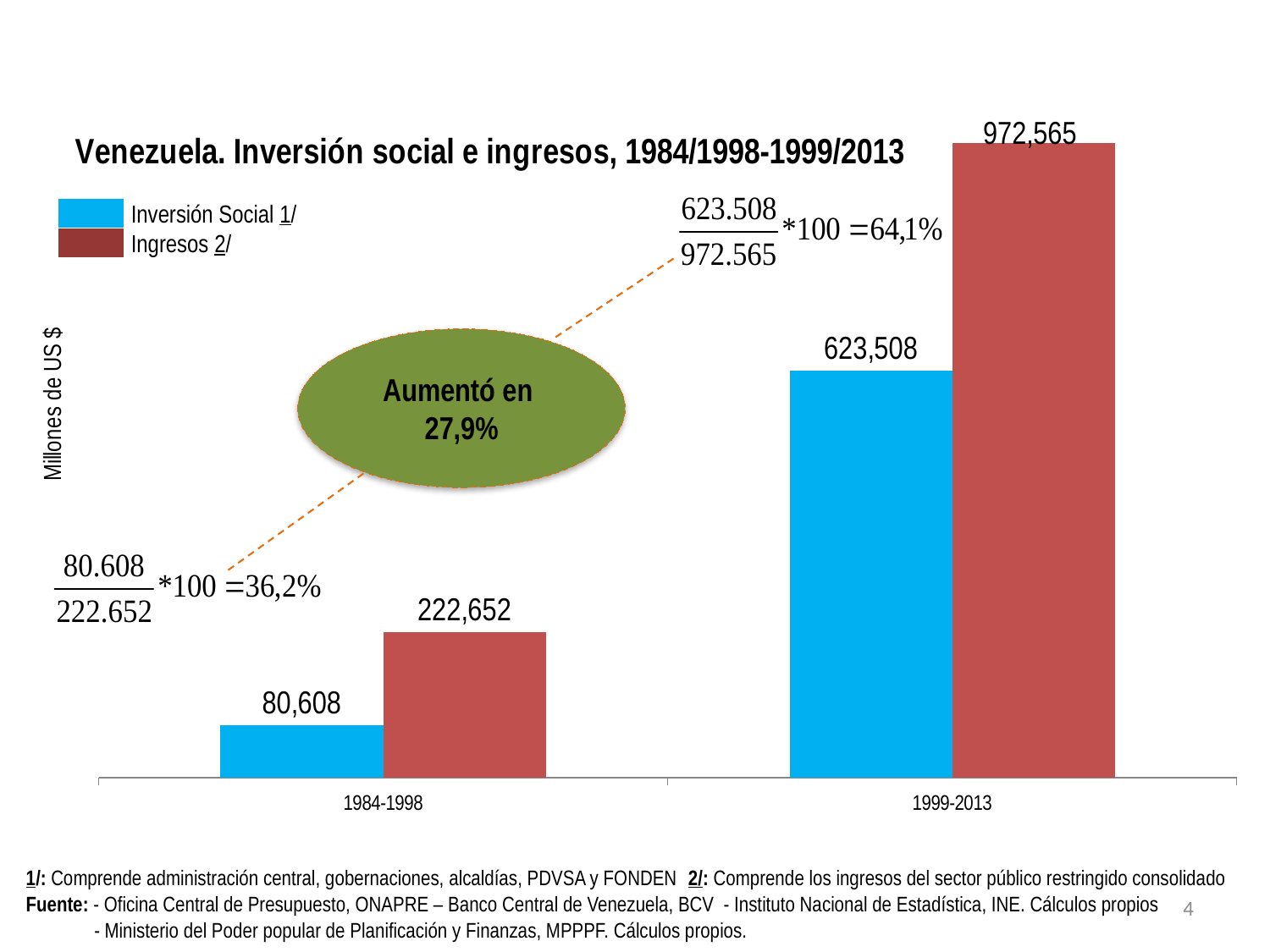
What is the value of Ingresos for 1999-2013? 972,565 Which period has the lowest Inversión Social value? 1984-1998 What is the value of Ingresos for 1984-1998? 222,652 Which period has the highest Ingresos value? 1999-2013 What is the value of Inversión Social for 1999-2013? 623,508 What is the difference between Ingresos and Inversión Social for 1984-1998? 142,044 What is the value of Inversión Social for 1984-1998? 80,608 How many periods are shown on the x axis? 2 What type of chart is shown on the slide? Bar chart What is the difference between Ingresos and Inversión Social for 1999-2013? 349,057 Which is larger: Inversión Social for 1999-2013 or Ingresos for 1984-1998? Inversión Social for 1999-2013 How many series does the legend list? 2